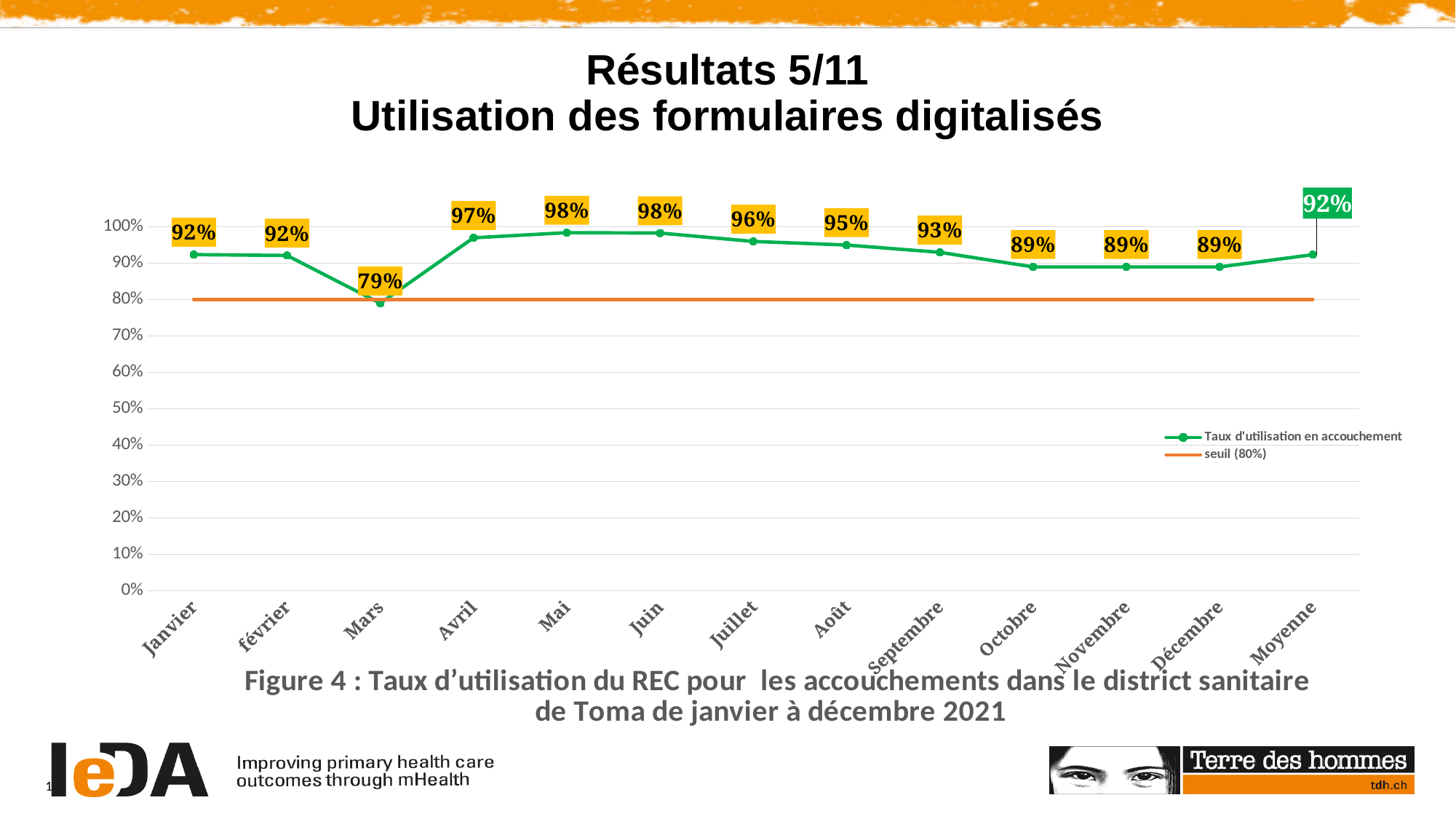
Is the value for Mars greater or less than 80%? less What is the value for Avril? 97% How many categories are shown on the x axis? 13 What is the value for Mars? 79% What is the value for Moyenne? 92% Which month has the lowest utilisation rate? Mars What threshold value is given in the legend for the orange line? 80% What kind of chart is shown? line chart Do the values rise or fall from Juin to Octobre? fall What is the difference between the values for Avril and Mars? 18% Which is larger, the value for Juillet or the value for Octobre? Juillet How many series does the legend list? 2